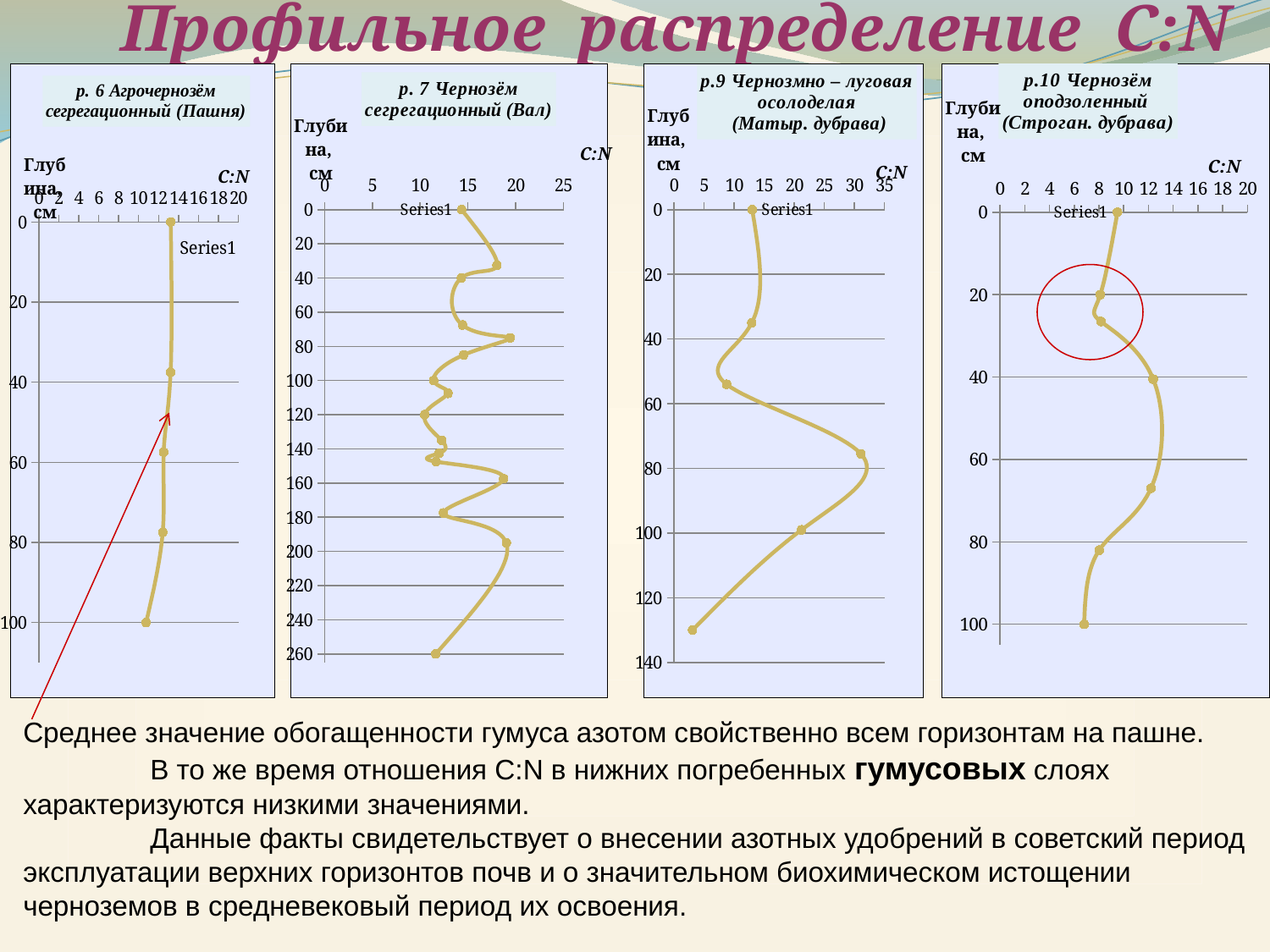
In the chart titled 'р.9 Чернозмно – луговая осолоделая (Матыр. дубрава)', how many data points are plotted? 6 In the chart titled 'р. 6 Агрочернозём сегрегационный (Пашня)', how many series does the legend list? 1 In the chart titled 'р.9 Чернозмно – луговая осолоделая (Матыр. дубрава)', is the C:N value at depth 75 greater or less than 25? greater In the chart titled 'р. 7 Чернозём сегрегационный (Вал)', what is the name of the series shown in the legend? Series1 In the chart titled 'р.10 Чернозём оподзоленный (Строган. дубрава)', is the C:N value at depth 100 greater or less than 10? less In the chart titled 'р. 6 Агрочернозём сегрегационный (Пашня)', how many data points are plotted? 5 In the chart titled 'р. 6 Агрочернозём сегрегационный (Пашня)', is the C:N value at depth 0 greater or less than 10? greater In the chart titled 'р. 6 Агрочернозём сегрегационный (Пашня)', what kind of chart is it? line chart How many charts are shown on the slide? 4